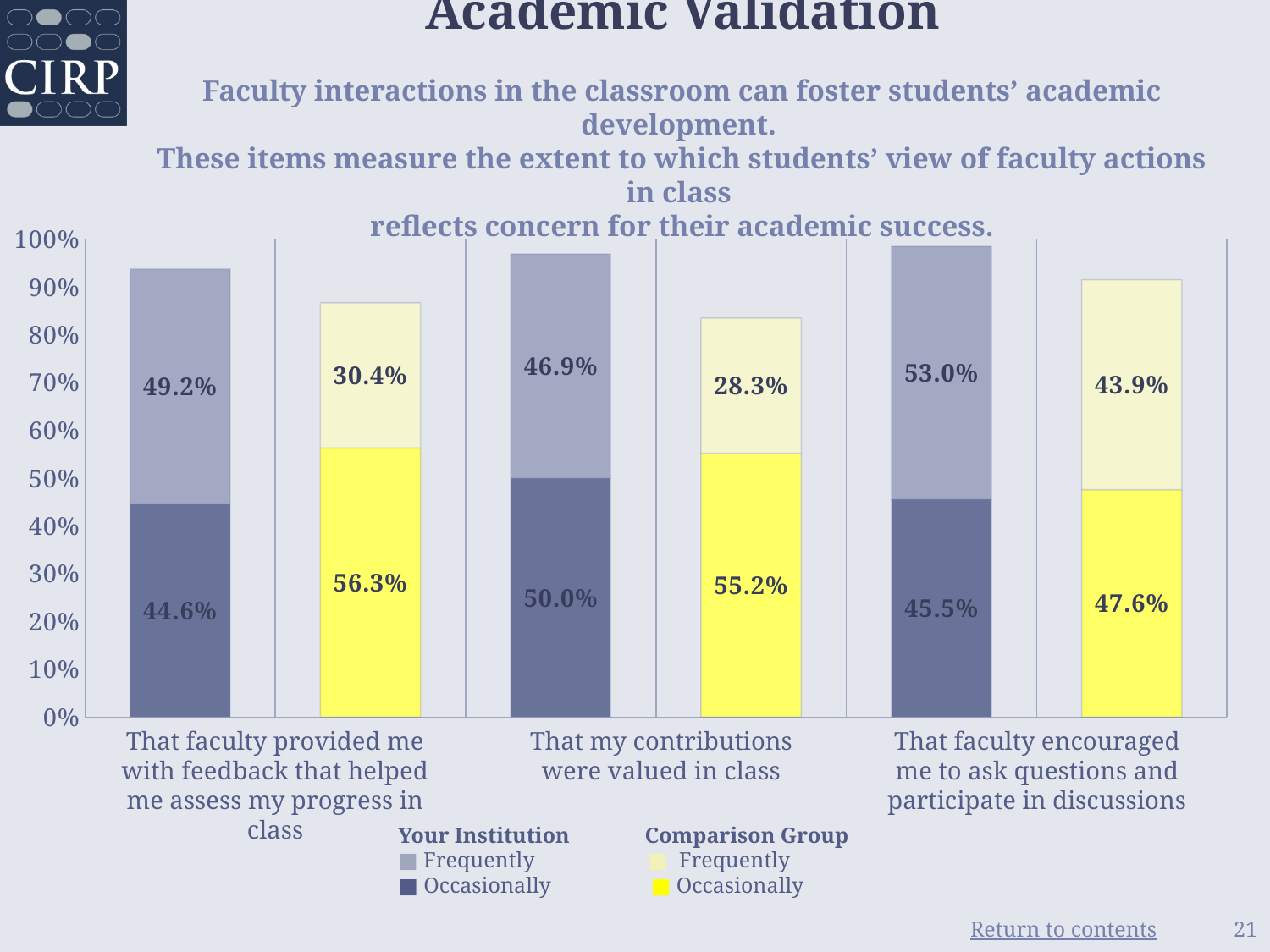
What is the total of the Comparison Group stacked bar for 'That faculty provided me with feedback that helped me assess my progress in class'? 86.7% What is the difference between the Your Institution and Comparison Group 'Frequently' values for 'That faculty provided me with feedback that helped me assess my progress in class'? 18.8% How many entries does the chart legend list? 4 What type of chart is shown on the slide? Stacked bar chart What percentage of Your Institution students reported that faculty provided feedback that helped them assess their progress in class 'Frequently'? 49.2% How many survey items (categories) are shown on the x axis of the chart? 3 Across the three items, which has the highest 'Frequently' value for the Comparison Group? That faculty encouraged me to ask questions and participate in discussions What percentage of the Comparison Group reported 'Occasionally' for 'That my contributions were valued in class'? 55.2% Which item has the lowest 'Frequently' value for the Comparison Group? That my contributions were valued in class For 'That my contributions were valued in class', which group has the larger 'Occasionally' value, Your Institution or the Comparison Group? Comparison Group What is the 'Frequently' value for Your Institution on 'That faculty encouraged me to ask questions and participate in discussions'? 53.0% What is the total height of the Your Institution stacked bar for 'That faculty encouraged me to ask questions and participate in discussions'? 98.5%